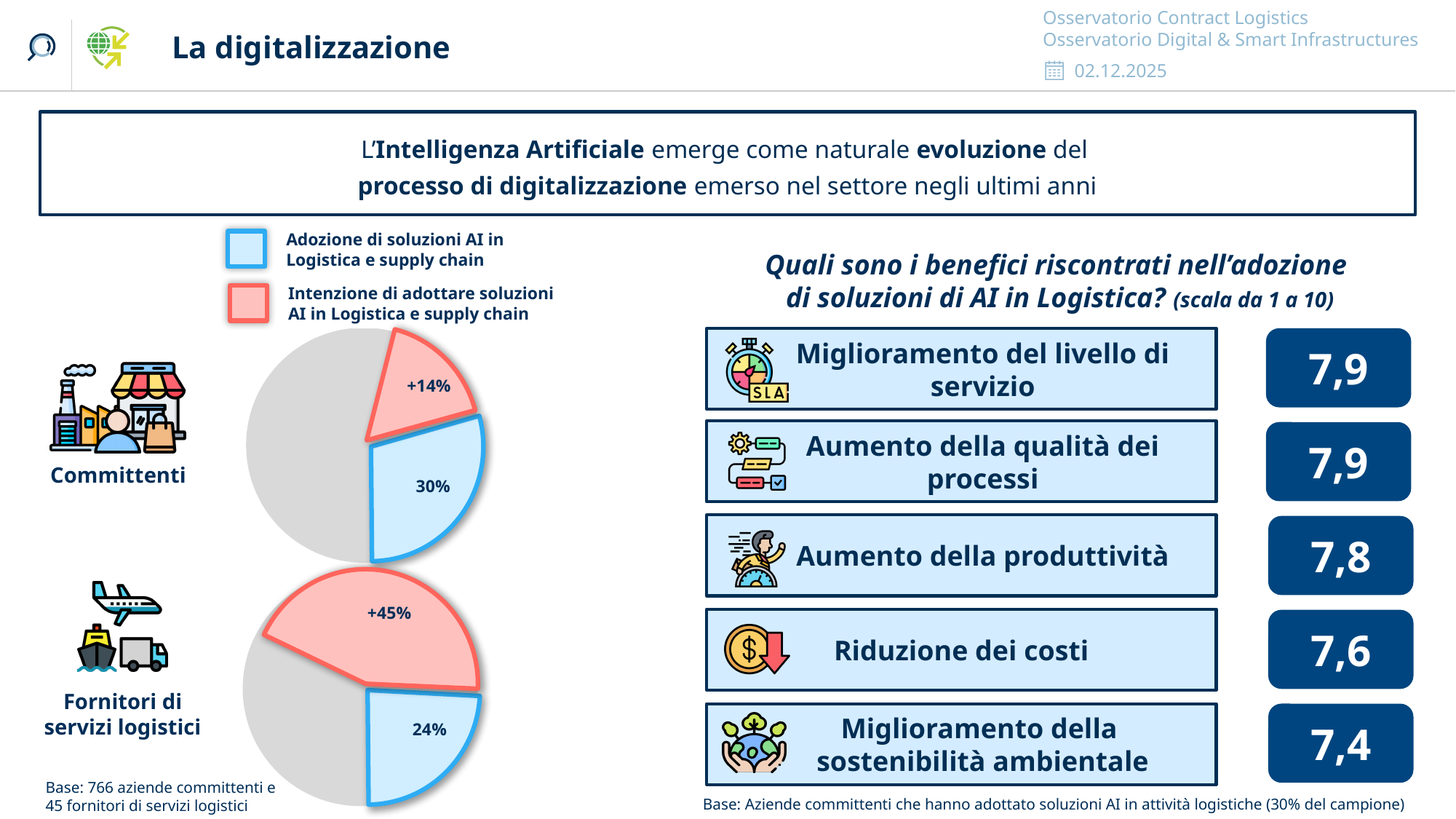
What is the difference in percentage points between the intention to adopt of Fornitori di servizi logistici and that of Committenti? 31 percentage points In the list of benefits from AI adoption in logistics, which benefit has the lowest score? Miglioramento della sostenibilità ambientale Which group shows a higher adoption share of AI solutions, Committenti or Fornitori di servizi logistici? Committenti Which group shows a higher intention to adopt AI solutions, Committenti or Fornitori di servizi logistici? Fornitori di servizi logistici In the Committenti pie chart, what percentage is shown for adoption of AI solutions in logistics and supply chain? 30% How many entries does the legend of the pie charts list? 2 In the Committenti pie chart, what is the combined share of adoption and intention to adopt AI solutions? 44% In the Committenti pie chart, what value is shown for the intention to adopt AI solutions? +14% What is the difference in percentage points between the adoption share of Committenti and that of Fornitori di servizi logistici? 6 percentage points What type of chart is used to show AI adoption for Committenti and Fornitori di servizi logistici? Pie chart In the Fornitori di servizi logistici pie chart, what value is shown for the intention to adopt AI solutions? +45% In the Fornitori di servizi logistici pie chart, what percentage is shown for adoption of AI solutions? 24%